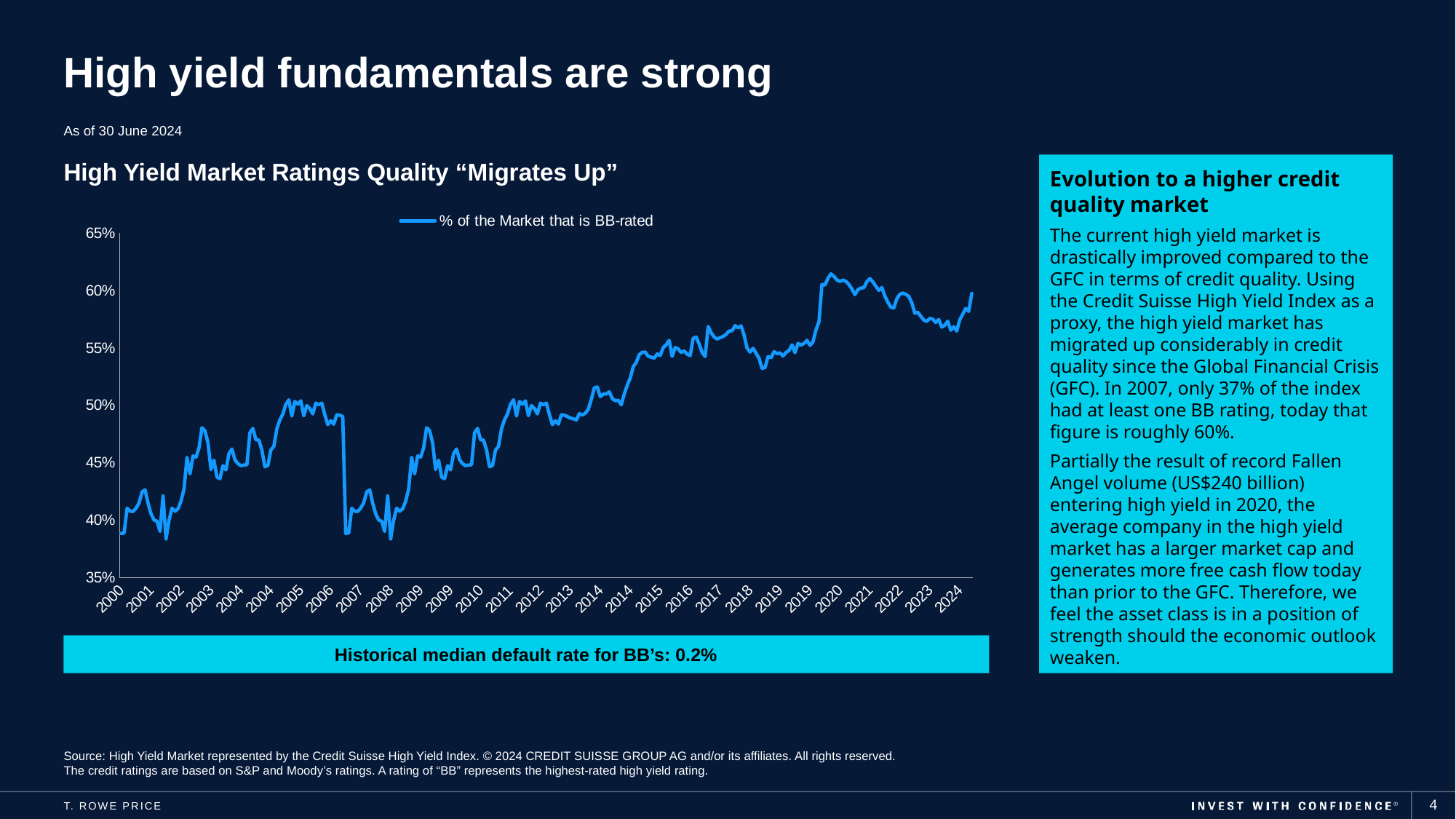
Is the value for the % of the Market that is BB-rated in 2010 greater or less than 50%? less Overall, does the % of the Market that is BB-rated rise or fall from 2000 to 2024? rise Which is higher, the % of the Market that is BB-rated in 2008 or in 2016? 2016 How many series does the chart legend list? 1 Around which year does the % of the Market that is BB-rated reach its highest point? 2020 What kind of chart is shown on the slide? Line chart What is the title of the chart? High Yield Market Ratings Quality "Migrates Up" Is the value for the % of the Market that is BB-rated at the end of 2024 greater or less than 55%? greater Is the value for the % of the Market that is BB-rated in 2008 greater or less than 45%? less What is the name of the series shown in the chart legend? % of the Market that is BB-rated